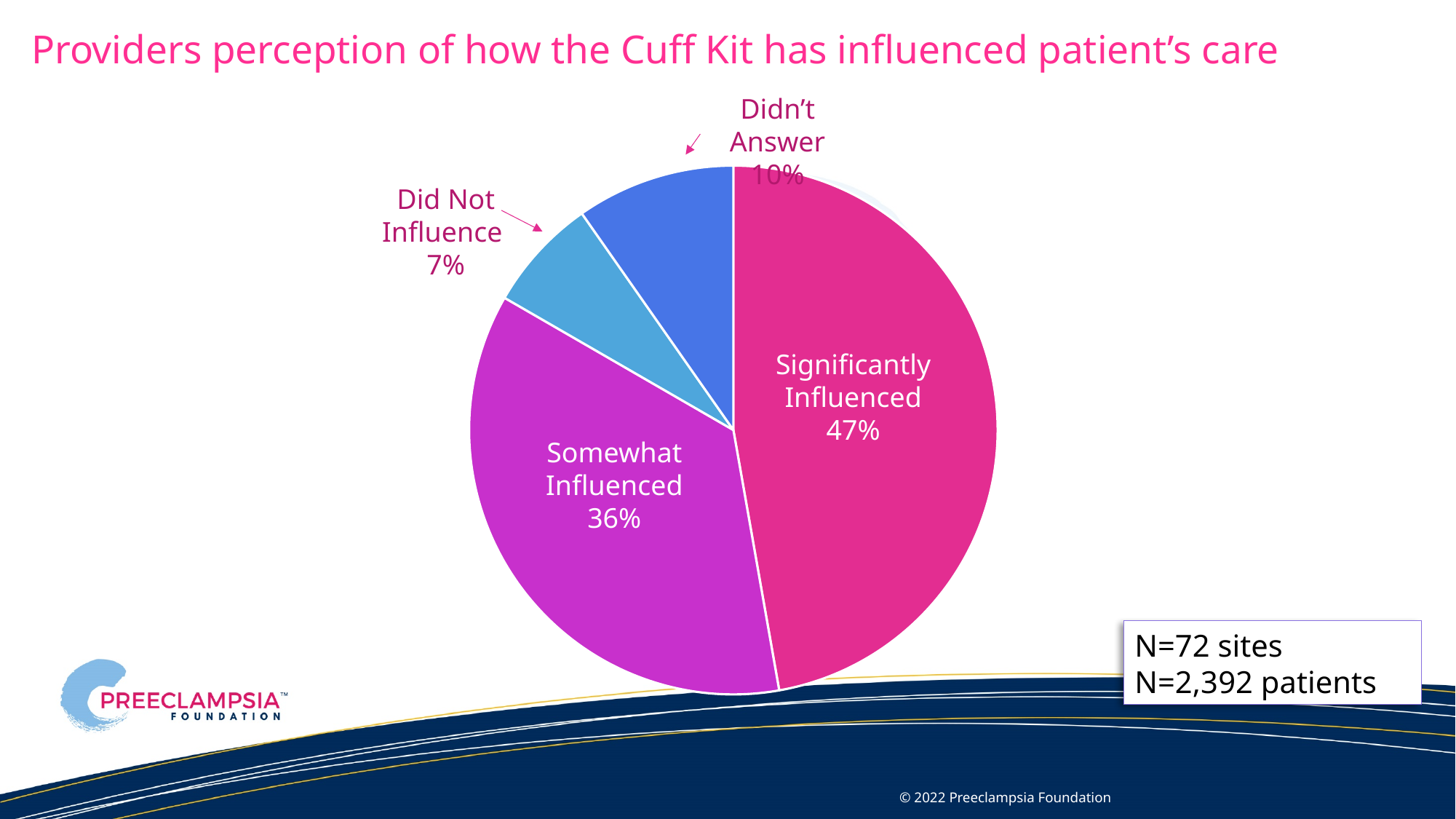
What kind of chart is shown on the slide? pie chart Which category has the largest slice of the pie? Significantly Influenced What is the difference in percentage points between Significantly Influenced and Somewhat Influenced? 11 What share of providers said the Cuff Kit Significantly Influenced patient's care? 47% How many sites are reported in the N box on the slide? N=72 sites What is the title of the chart? Providers perception of how the Cuff Kit has influenced patient's care What share of providers Didn't Answer? 10% Which category has the smallest slice of the pie? Did Not Influence What share of providers said the Cuff Kit Somewhat Influenced patient's care? 36% Which is larger, the share for Didn't Answer or the share for Did Not Influence? Didn't Answer What share of providers said the Cuff Kit Did Not Influence patient's care? 7% How many slices does the pie chart have? 4